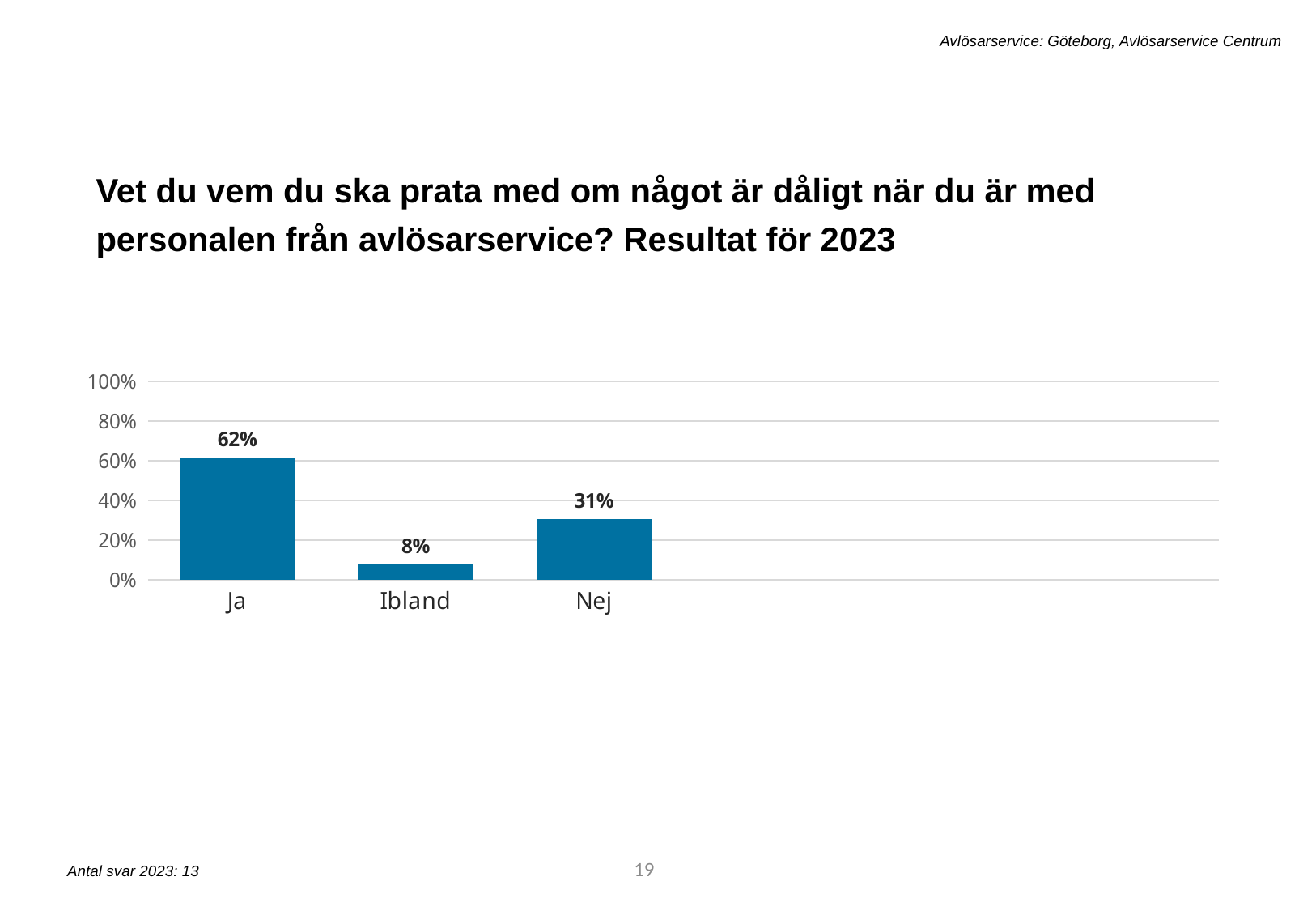
What is the value for Ibland? 8% Which category has the highest value? Ja Which is larger, the value for Nej or the value for Ibland? Nej What is the value for Ja? 62% Is the value for Ja greater or less than 40%? greater What is the difference between the values for Ja and Nej? 31% What kind of chart is shown on the slide? bar chart How many categories are shown on the x axis? 3 What is the value for Nej? 31% What is the highest value shown on the y axis? 100% Which category has the lowest value? Ibland What is the difference between the values for Nej and Ibland? 23%